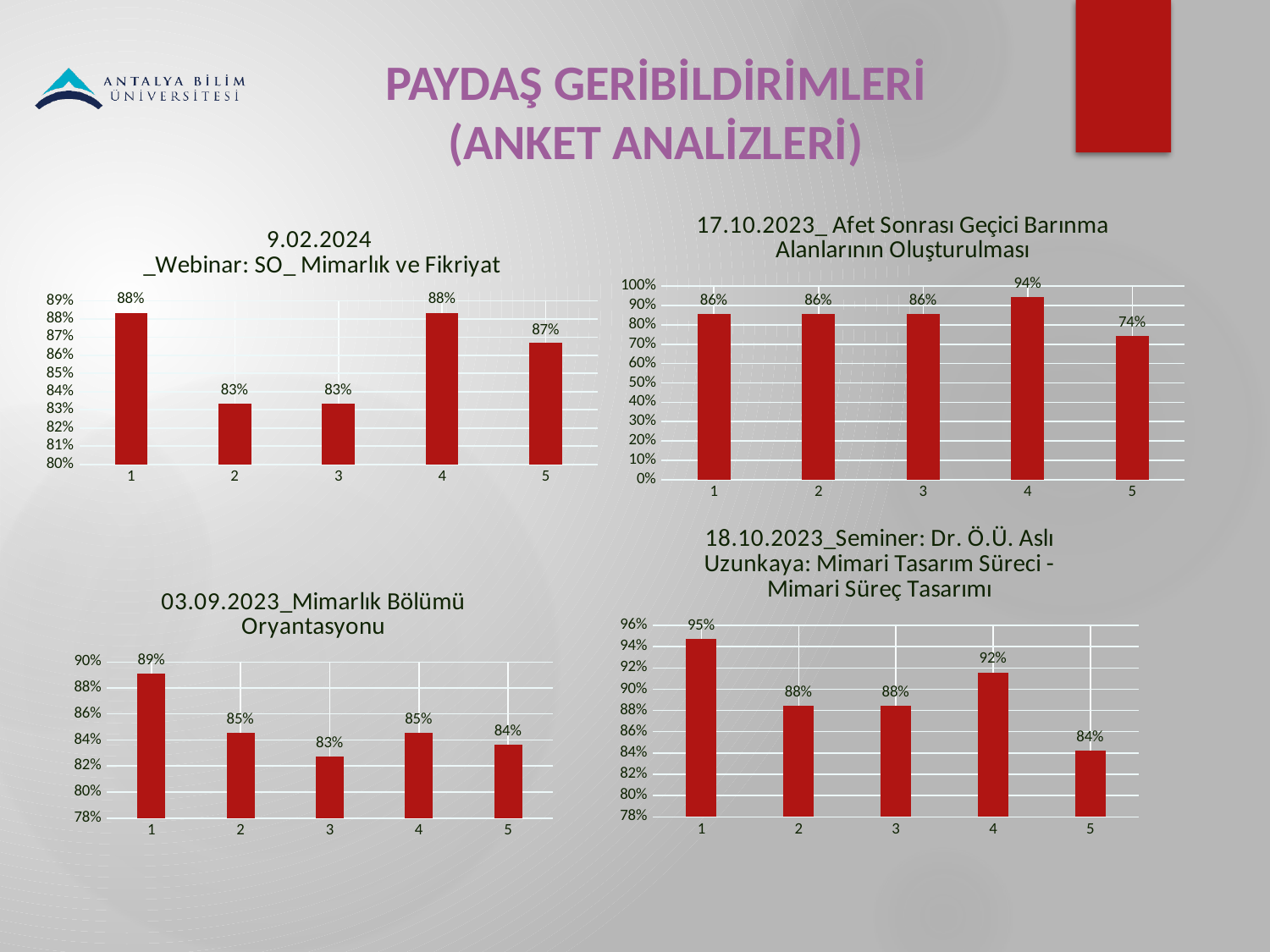
In the chart titled "17.10.2023_ Afet Sonrası Geçici Barınma Alanlarının Oluşturulması", what is the value for category 4? 94% In the chart titled "9.02.2024 _Webinar: SO_ Mimarlık ve Fikriyat", what is the value for category 5? 87% In the chart titled "03.09.2023_Mimarlık Bölümü Oryantasyonu", what is the value for category 3? 83% In the bottom-right chart (18.10.2023_Seminer: Dr. Ö.Ü. Aslı Uzunkaya), what is the value for category 1? 95% In the chart titled "17.10.2023_ Afet Sonrası Geçici Barınma Alanlarının Oluşturulması", which category has the lowest value? 5 In the chart titled "03.09.2023_Mimarlık Bölümü Oryantasyonu", which category has the highest value? 1 In the chart titled "9.02.2024 _Webinar: SO_ Mimarlık ve Fikriyat", which is larger, the value for category 1 or category 2? Category 1 What kind of chart is the top-left chart titled "9.02.2024 _Webinar: SO_ Mimarlık ve Fikriyat"? Bar chart In the chart titled "03.09.2023_Mimarlık Bölümü Oryantasyonu", how many categories are shown on the x axis? 5 In the bottom-right chart (18.10.2023_Seminer: Dr. Ö.Ü. Aslı Uzunkaya), what is the difference between the values for category 1 and category 5? 11% In the bottom-right chart (18.10.2023_Seminer: Dr. Ö.Ü. Aslı Uzunkaya), is the value for category 4 greater or less than 90%? greater In the chart titled "17.10.2023_ Afet Sonrası Geçici Barınma Alanlarının Oluşturulması", what is the difference between the values for category 4 and category 5? 20%